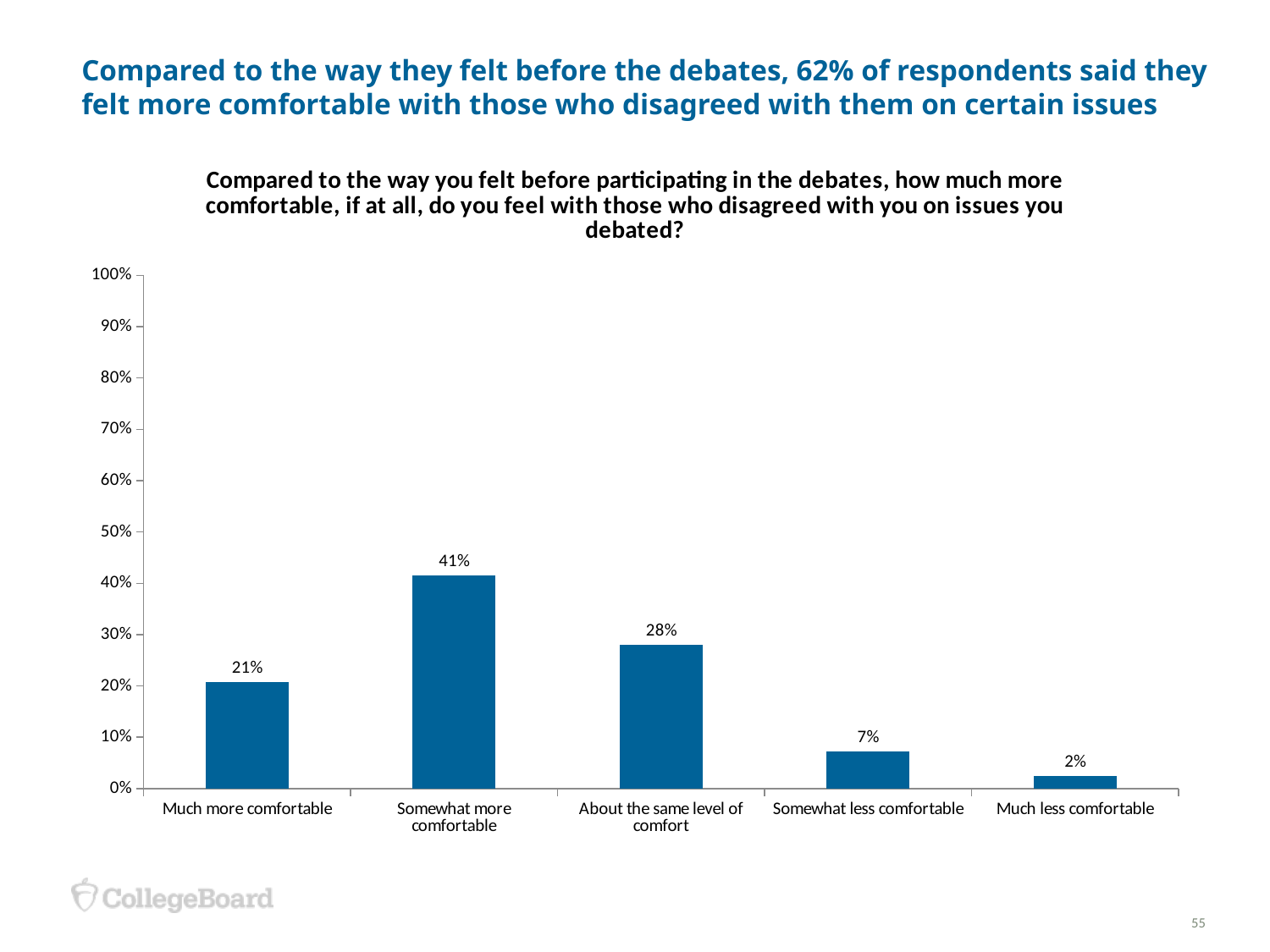
What kind of chart is shown on the slide? Bar chart Which is larger: "About the same level of comfort" or "Much more comfortable"? About the same level of comfort How many categories are shown on the x axis? 5 Which category has the lowest value? Much less comfortable What percentage of respondents reported "About the same level of comfort"? 28% What is the difference between "Somewhat more comfortable" and "Much more comfortable"? 20% What is the difference between "Somewhat less comfortable" and "Much less comfortable"? 5% What percentage of respondents said they felt "Much more comfortable"? 21% Which category has the highest value? Somewhat more comfortable What is the value for "Much less comfortable"? 2% What is the maximum value shown on the y axis? 100% What is the value for "Somewhat more comfortable"? 41%